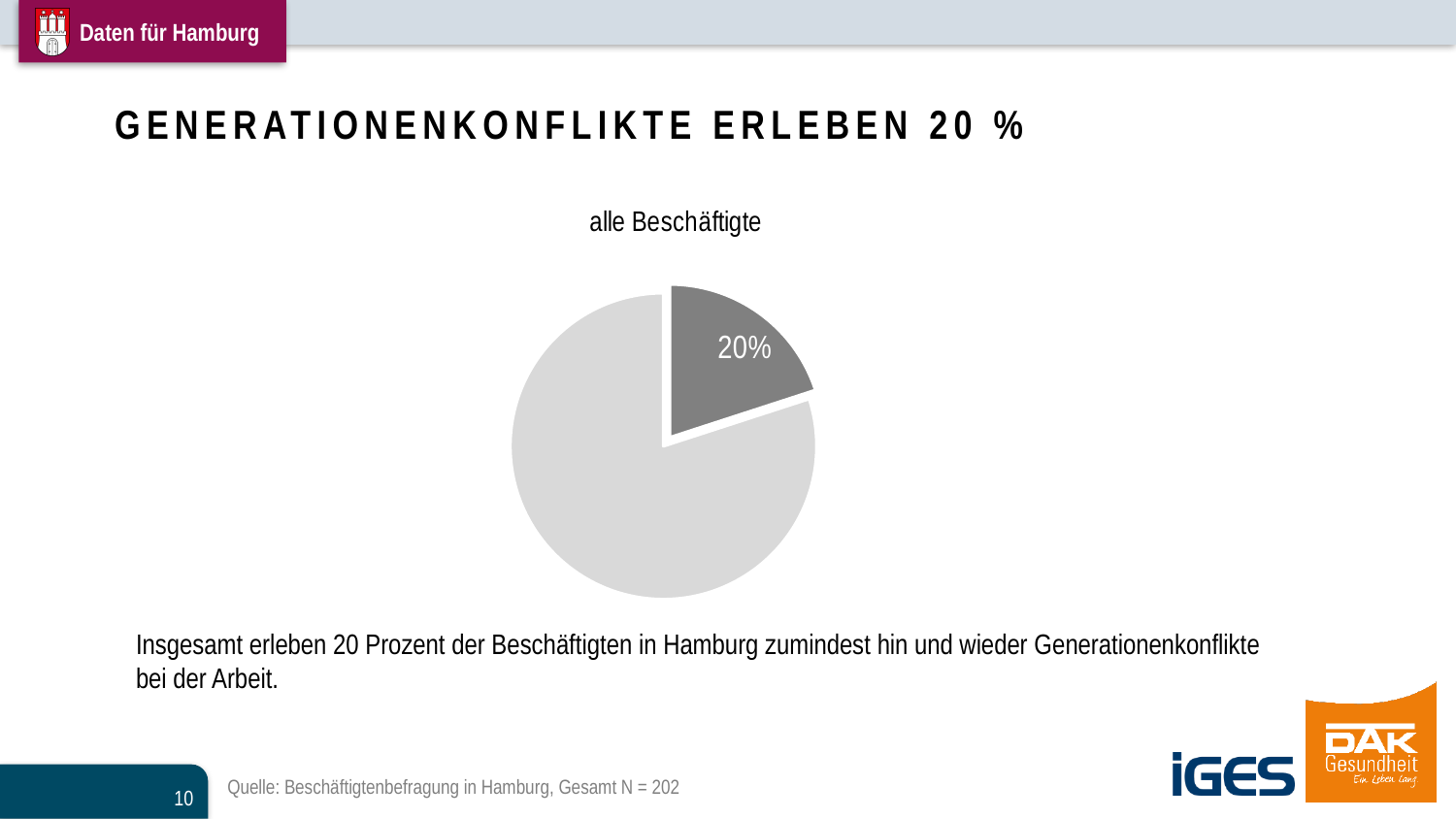
What is the title of the chart? alle Beschäftigte Which slice of the pie chart is the smallest? the dark grey slice (20%) How many slices of the pie chart carry a printed data label? 1 Is the share of the light grey slice greater or less than 50%? greater Which slice is larger, the dark grey slice or the light grey slice? the light grey slice What value is printed on the dark grey slice of the pie chart? 20% Is the share of the dark grey slice greater or less than 50%? less How many slices does the pie chart have? 2 What kind of chart is shown on the slide? pie chart What share of the pie does the dark grey slice represent? 20%